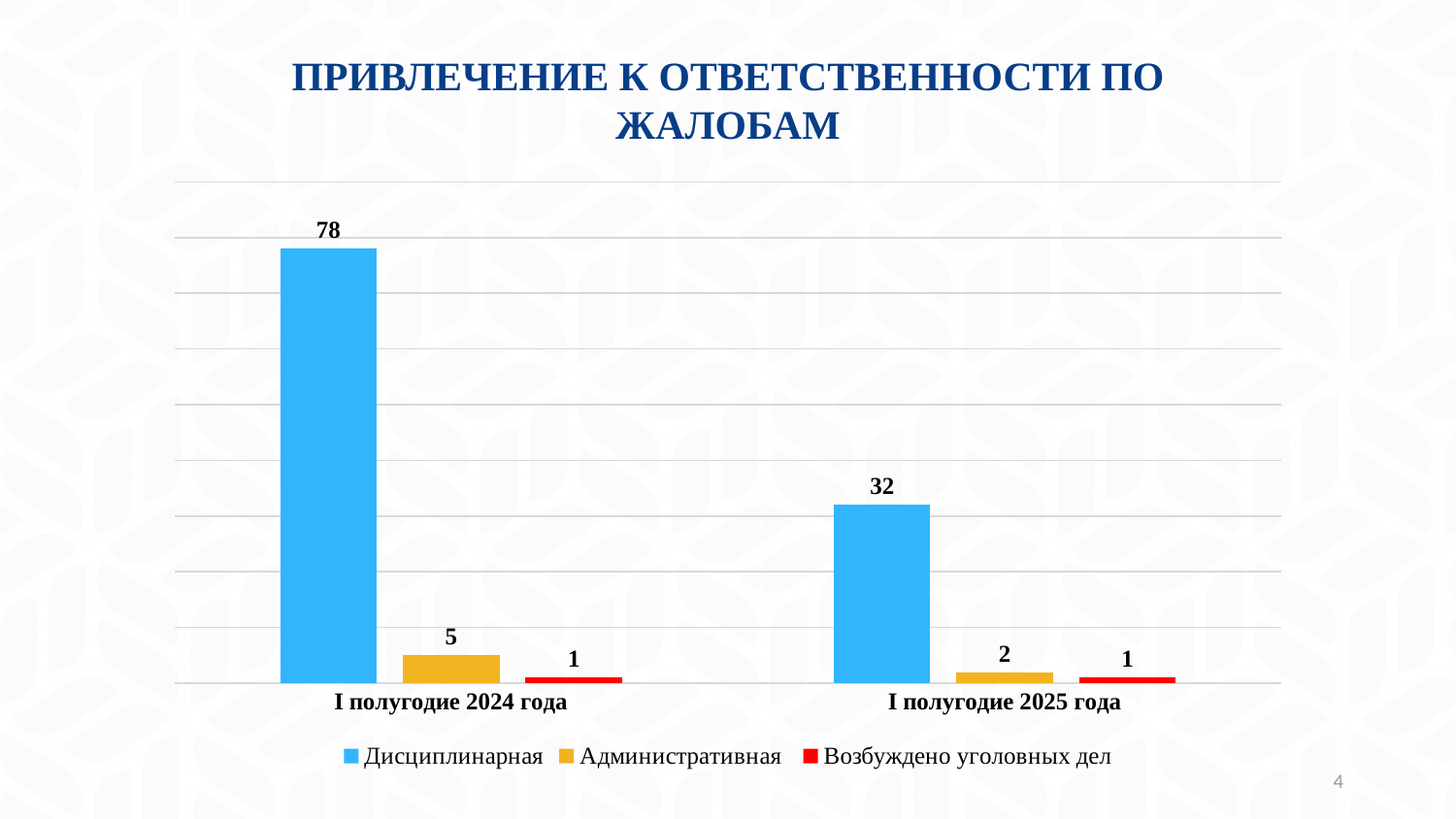
Which series has the highest value in I полугодие 2024 года? Дисциплинарная What is the value for Административная in I полугодие 2025 года? 2 What is the value for Возбуждено уголовных дел in I полугодие 2024 года? 1 Which is larger: Административная in I полугодие 2024 года or Административная in I полугодие 2025 года? I полугодие 2024 года What is the difference between the Дисциплинарная values for I полугодие 2024 года and I полугодие 2025 года? 46 Which series has the lowest value in I полугодие 2025 года? Возбуждено уголовных дел How many categories are shown on the x axis? 2 How many series does the legend list? 3 Does the Дисциплинарная value rise or fall from I полугодие 2024 года to I полугодие 2025 года? Fall What is the value for Дисциплинарная in I полугодие 2025 года? 32 What is the value for Дисциплинарная in I полугодие 2024 года? 78 What kind of chart is shown on the slide? Bar chart